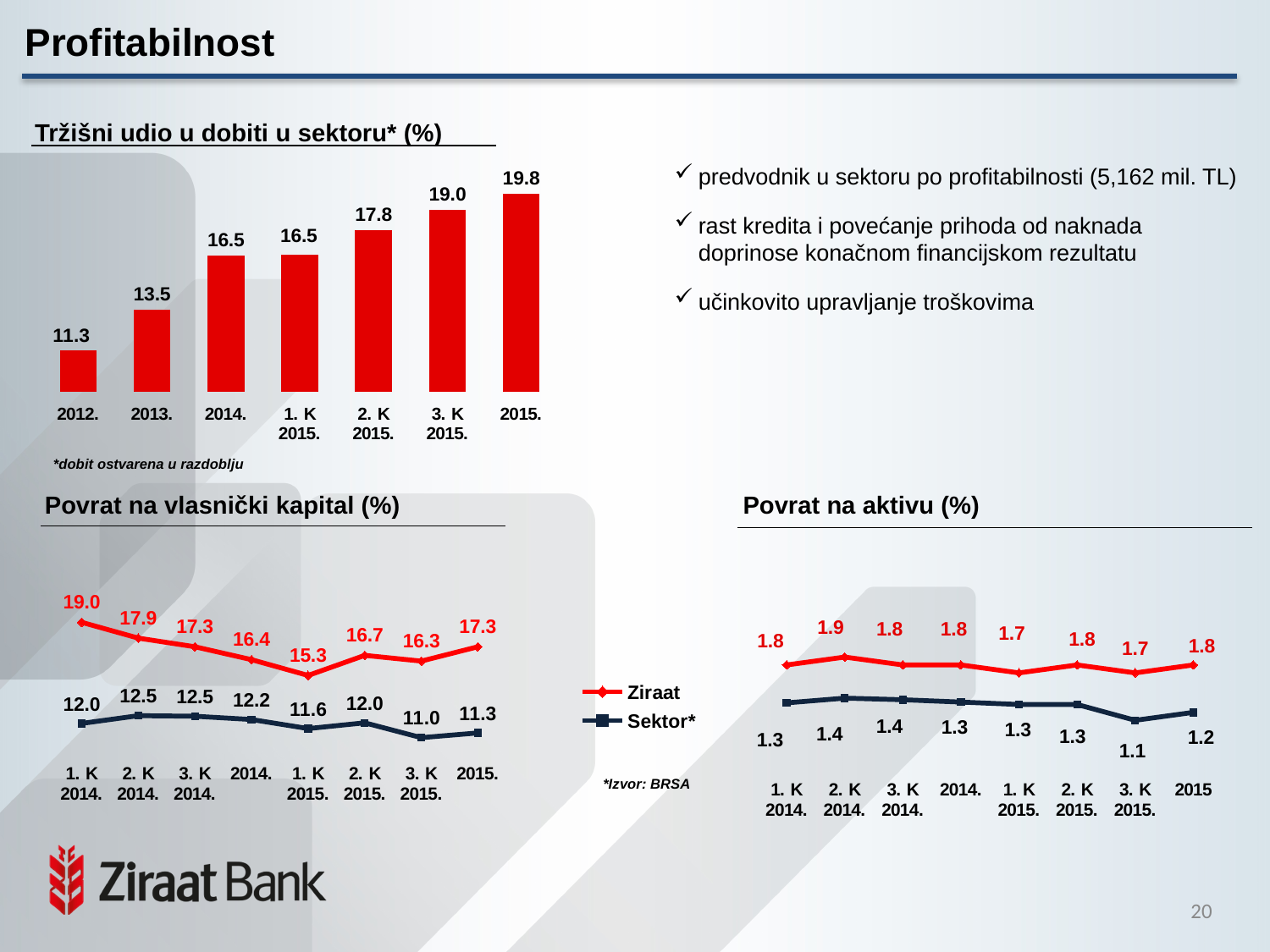
In the 'Povrat na aktivu (%)' chart, which is larger for 2. K 2014.: the Ziraat value or the Sektor value? Ziraat In the 'Tržišni udio u dobiti u sektoru* (%)' chart, do the values generally rise or fall from 2012. to 2015.? Rise In the 'Povrat na aktivu (%)' chart, what is the Sektor value for 3. K 2015.? 1.1 How many series does the legend of the 'Povrat na vlasnički kapital (%)' chart list? 2 In the 'Tržišni udio u dobiti u sektoru* (%)' chart, what is the value for 2013.? 13.5 In the 'Povrat na vlasnički kapital (%)' chart, which period has the lowest Sektor* value? 3. K 2015. In the 'Povrat na vlasnički kapital (%)' chart, what is the difference between the Ziraat and Sektor* values for 2015.? 6.0 In the 'Povrat na vlasnički kapital (%)' chart, what is the Ziraat value for 1. K 2015.? 15.3 In the 'Tržišni udio u dobiti u sektoru* (%)' chart, how many bars are shown? 7 In the 'Tržišni udio u dobiti u sektoru* (%)' chart, which category has the highest value? 2015. What kind of chart is 'Tržišni udio u dobiti u sektoru* (%)'? Bar chart In the 'Tržišni udio u dobiti u sektoru* (%)' chart, what is the difference between the values for 2015. and 2012.? 8.5